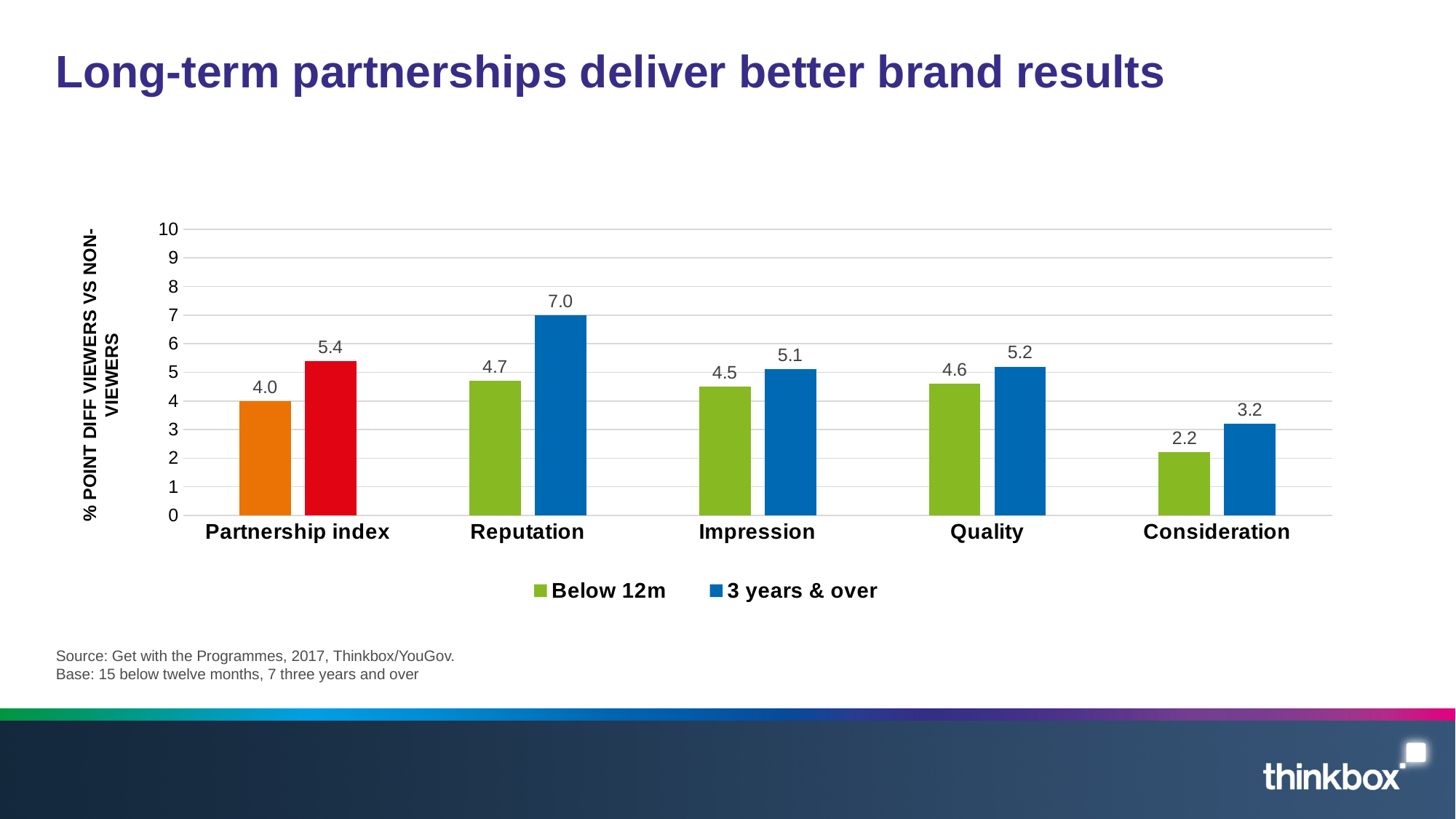
What is the difference between the '3 years & over' and 'Below 12m' values for Reputation? 2.3 What kind of chart is shown on the slide? Bar chart What is the difference between the '3 years & over' and 'Below 12m' values for Partnership index? 1.4 Which category has the lowest value for the 'Below 12m' series? Consideration Which category has the highest value for the '3 years & over' series? Reputation What is the value for '3 years & over' in the Reputation category? 7.0 How many categories are shown on the x axis? 5 Which is larger for Quality: the 'Below 12m' value or the '3 years & over' value? 3 years & over How many series does the legend list? 2 What is the value for 'Below 12m' in the Consideration category? 2.2 What is the value for 'Below 12m' in the Partnership index category? 4.0 Is the '3 years & over' value for Impression greater or less than 4? greater